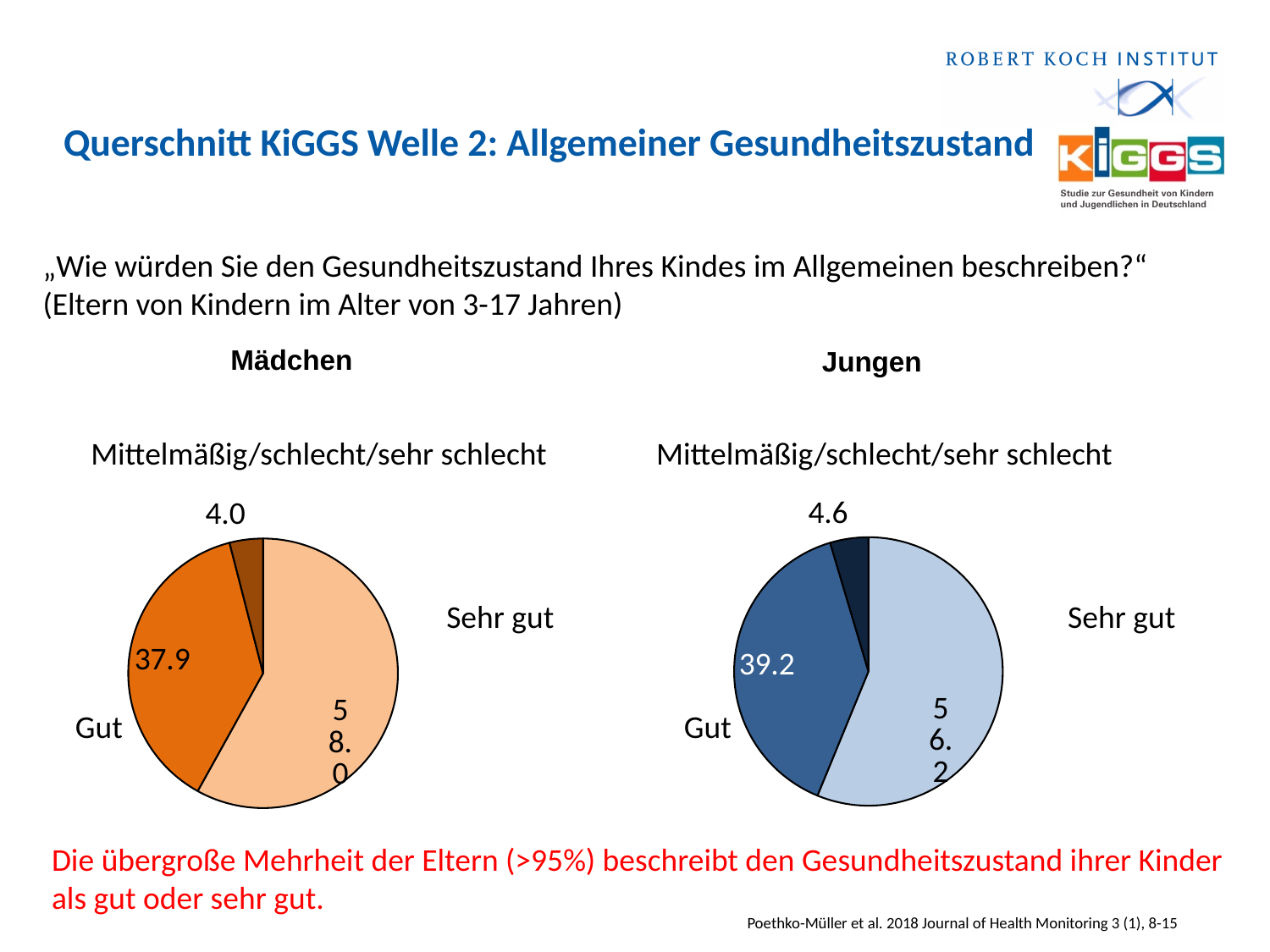
In the Jungen pie chart, what is the value for Mittelmäßig/schlecht/sehr schlecht? 4.6 In the Mädchen pie chart, what is the difference between the Sehr gut and Gut values? 20.1 What type of chart is used for the Mädchen data? Pie chart Which is larger: the Gut value for Mädchen or the Gut value for Jungen? Jungen In the Mädchen pie chart, what is the value for Mittelmäßig/schlecht/sehr schlecht? 4.0 How many slices does the Jungen pie chart have? 3 In the Mädchen pie chart, what is the value for Gut? 37.9 In the Jungen pie chart, which category has the smallest slice? Mittelmäßig/schlecht/sehr schlecht What is the title of the chart on the right side of the slide? Jungen In the Mädchen pie chart, which category has the largest slice? Sehr gut In the Jungen pie chart, what is the value for Gut? 39.2 In the Jungen pie chart, what is the value for Sehr gut? 56.2